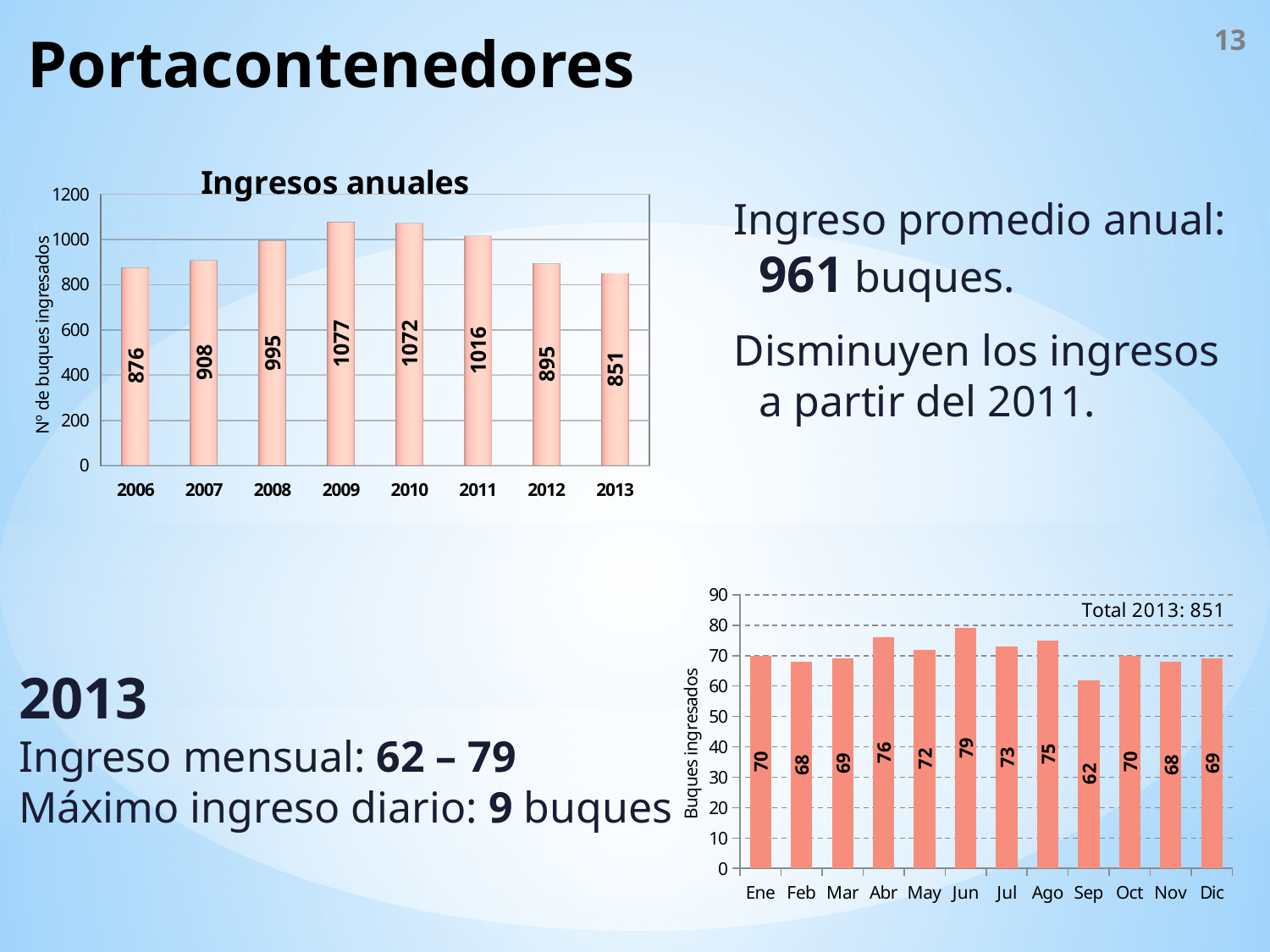
In the 'Ingresos anuales' chart, what is the y-axis title? Nº de buques ingresados In the 'Ingresos anuales' chart, which year has the lowest value? 2013 In the 'Ingresos anuales' chart, is the value for 2008 greater or less than 1000? less In the 'Ingresos anuales' chart, what is the value for 2009? 1077 In the monthly chart at the bottom right, which is larger, the value for Abr or the value for Ago? Abr In the monthly chart at the bottom right, which month has the highest value? Jun What kind of chart is the monthly chart at the bottom right? bar chart In the 'Ingresos anuales' chart, what is the difference between the values for 2011 and 2012? 121 In the monthly chart at the bottom right, what is the difference between the values for Jun and Sep? 17 In the 'Ingresos anuales' chart, which year has the highest value? 2009 In the monthly chart at the bottom right, what is the value for Sep? 62 In the 'Ingresos anuales' chart, how many years are shown on the x axis? 8